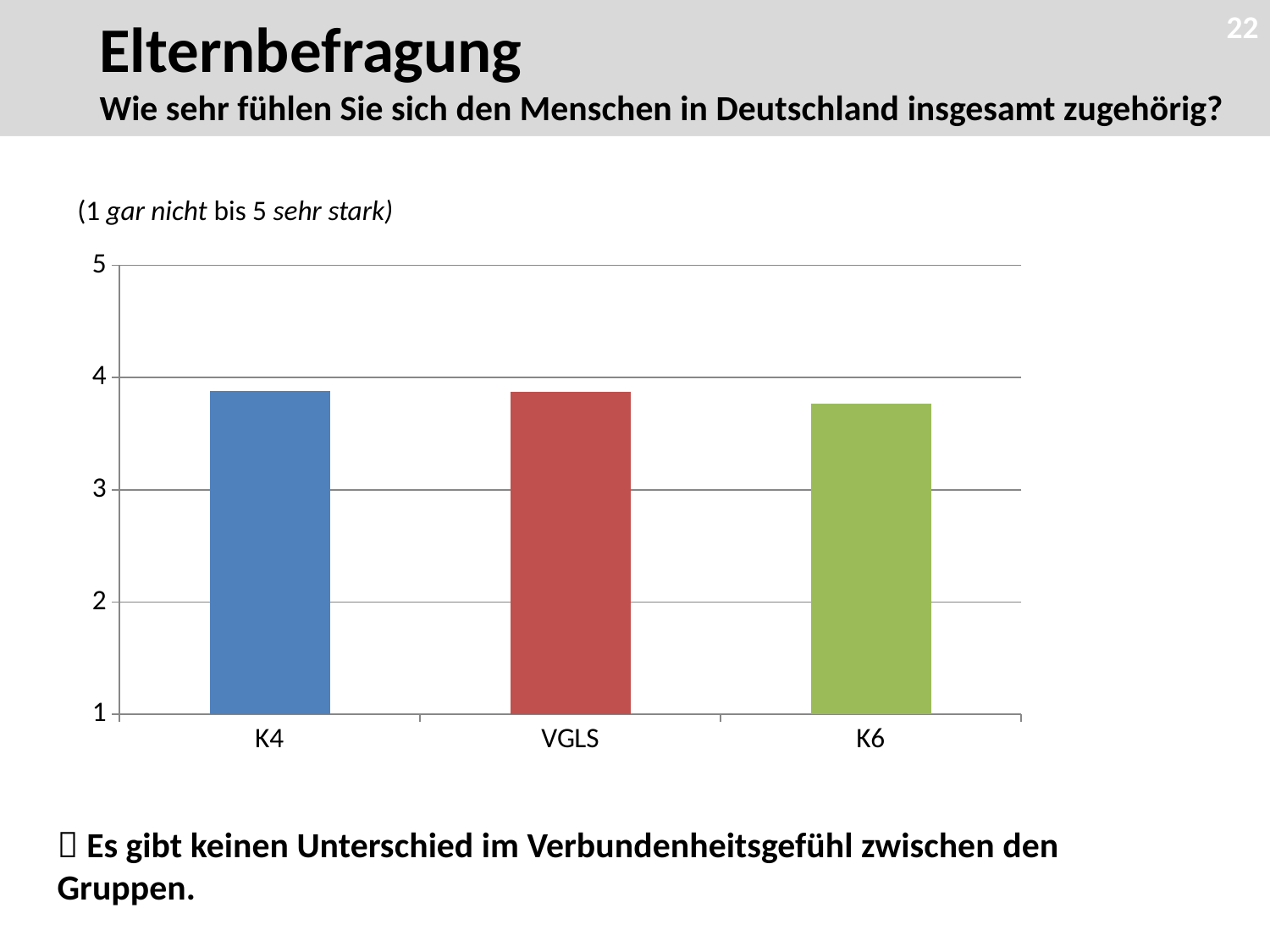
What kind of chart is shown on the slide? bar chart What are the category labels on the x axis of the chart, from left to right? K4, VGLS, K6 Is the value for VGLS greater or less than 4? less What is the highest value shown on the y axis of the chart? 5 Is the value for K4 greater or less than 4? less Is the value for K6 greater or less than 4? less How many categories are shown on the x axis of the chart? 3